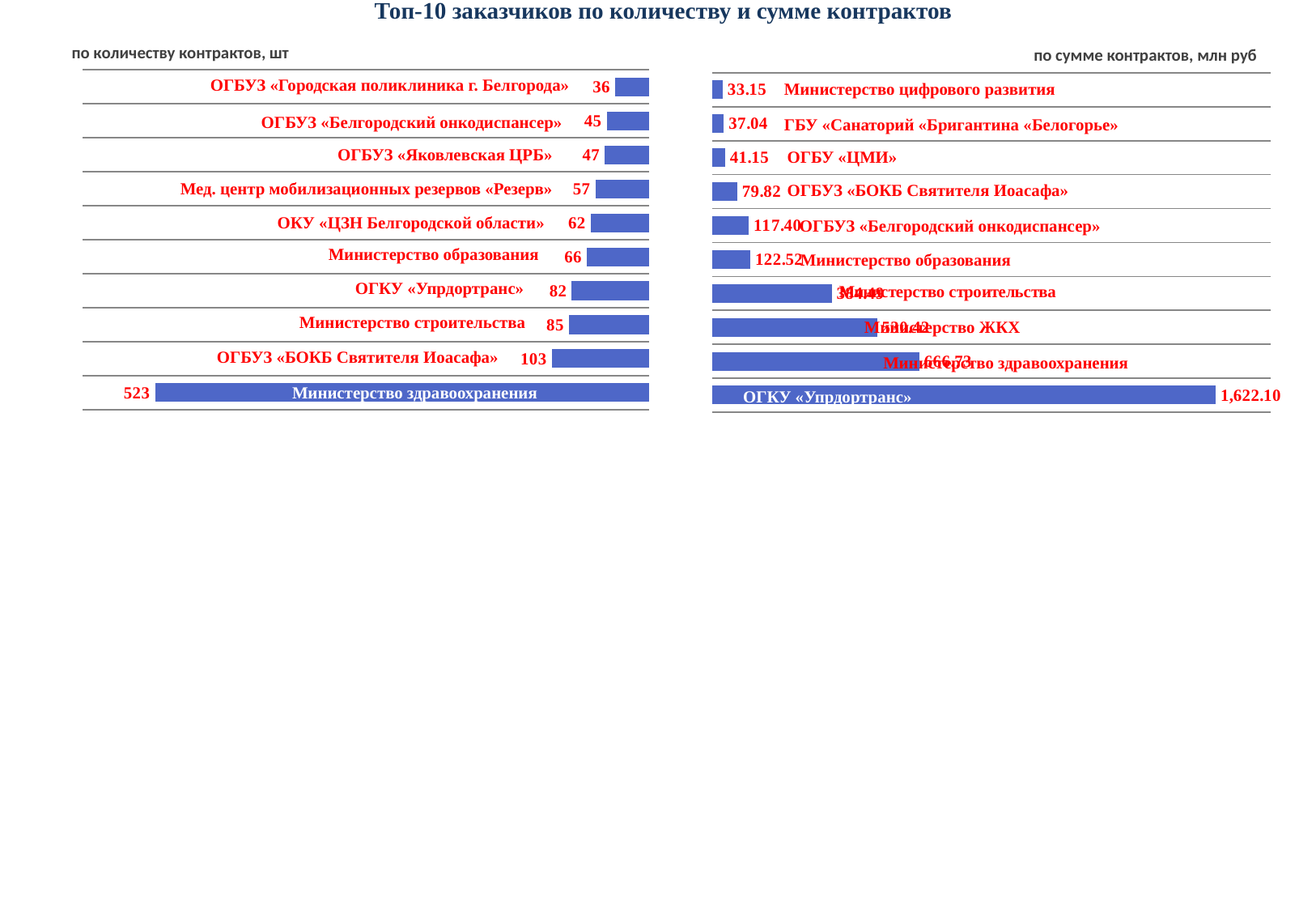
In the left chart (по количеству контрактов, шт), which customer has the lowest number of contracts? ОГБУЗ «Городская поликлиника г. Белгорода» In the right chart (по сумме контрактов, млн руб), what is the difference between Министерство образования and ОГБУЗ «БОКБ Святителя Иоасафа»? 42.70 In the left chart (по количеству контрактов, шт), what is the difference between ОГБУЗ «БОКБ Святителя Иоасафа» and Министерство строительства? 18 In the right chart (по сумме контрактов, млн руб), what is the value for ОГКУ «Упрдортранс»? 1,622.10 In the left chart (по количеству контрактов, шт), which customer has the highest number of contracts? Министерство здравоохранения In the left chart (по количеству контрактов, шт), how many customers are shown? 10 In the left chart (по количеству контрактов, шт), how many contracts does Министерство здравоохранения have? 523 In the left chart (по количеству контрактов, шт), what is the value for ОГБУЗ «Яковлевская ЦРБ»? 47 What type of chart is used on the left side of the slide? Bar chart In the left chart (по количеству контрактов, шт), which has more contracts: ОГКУ «Упрдортранс» or Министерство образования? ОГКУ «Упрдортранс» In the right chart (по сумме контрактов, млн руб), what is the value for ОГБУЗ «Белгородский онкодиспансер»? 117.40 In the right chart (по сумме контрактов, млн руб), which customer has the lowest contract sum? Министерство цифрового развития